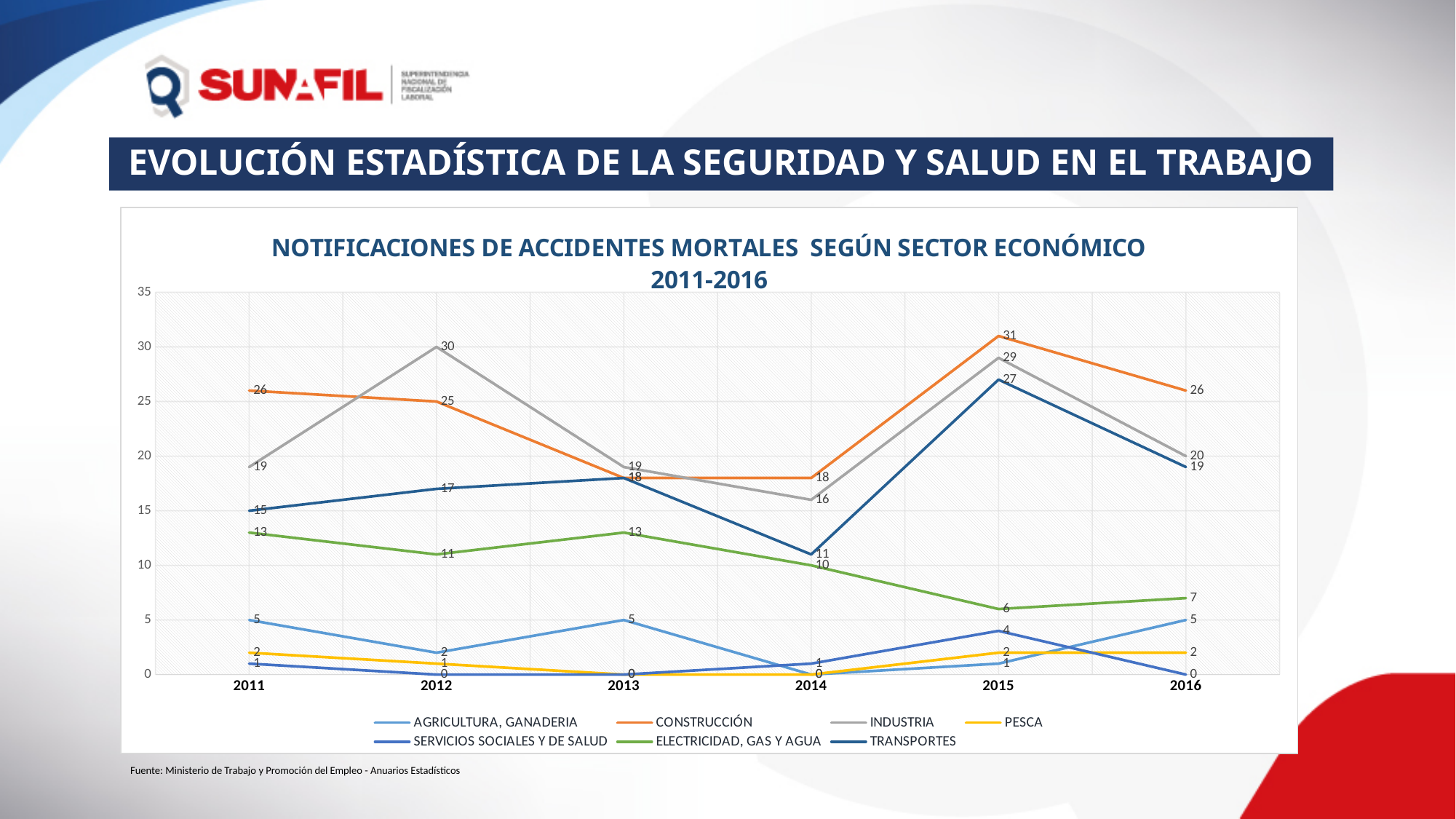
What type of chart is shown on the slide? Line chart What is the value for TRANSPORTES in 2014? 11 Does the ELECTRICIDAD, GAS Y AGUA line rise or fall from 2013 to 2015? Fall What is the value for INDUSTRIA in 2012? 30 How many years are shown on the x axis? 6 Which sector has the highest value in 2012? INDUSTRIA Is the value for TRANSPORTES in 2015 greater or less than 25? greater What is the value for CONSTRUCCIÓN in 2015? 31 How many series does the legend list? 7 In 2016, which is larger: CONSTRUCCIÓN or INDUSTRIA? CONSTRUCCIÓN What is the difference between CONSTRUCCIÓN and INDUSTRIA in 2015? 2 What is the value for ELECTRICIDAD, GAS Y AGUA in 2015? 6